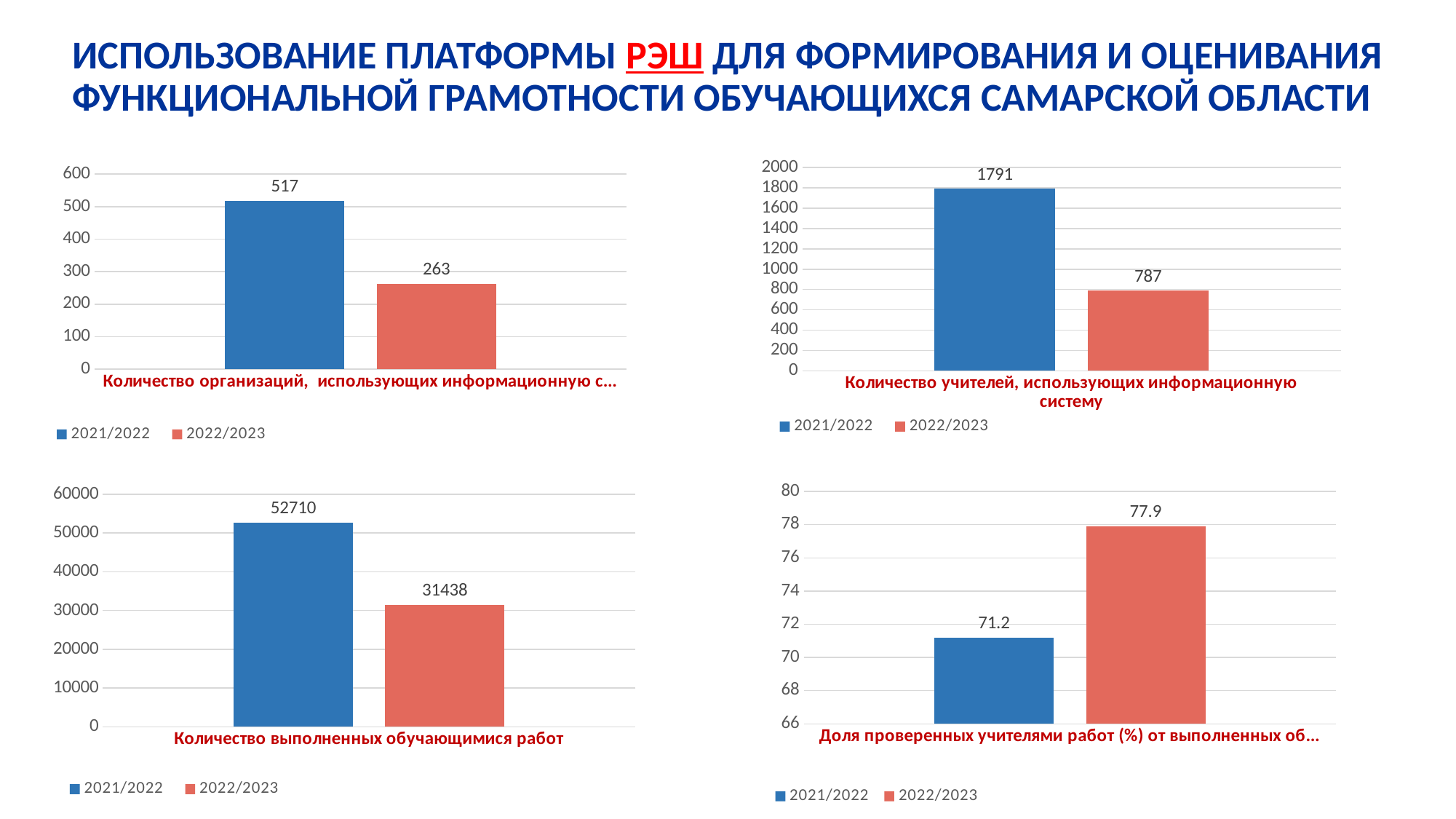
In the bottom-left chart (number of works completed by students), what is the value for 2022/2023? 31438 In the top-right chart (number of teachers using the information system), what is the difference between the 2021/2022 and 2022/2023 values? 1004 In the bottom-right chart (share of works checked by teachers, %), which series has the lowest value? 2021/2022 In the top-right chart (number of teachers using the information system), what is the value for 2021/2022? 1791 In the top-left chart (number of organizations using the information system), what is the value for 2021/2022? 517 In the top-left chart, what colour is the bar for the 2022/2023 series? Red In the bottom-right chart (share of works checked by teachers, %), what is the value for 2022/2023? 77.9 How many series does the legend of the top-left chart list? 2 In the bottom-left chart (number of works completed by students), which series has the higher value, 2021/2022 or 2022/2023? 2021/2022 In the bottom-right chart (share of works checked by teachers, %), what is the difference between the 2022/2023 and 2021/2022 values? 6.7 What kind of chart is the top-right chart (number of teachers using the information system)? Bar chart In the top-left chart (number of organizations using the information system), what is the value for 2022/2023? 263